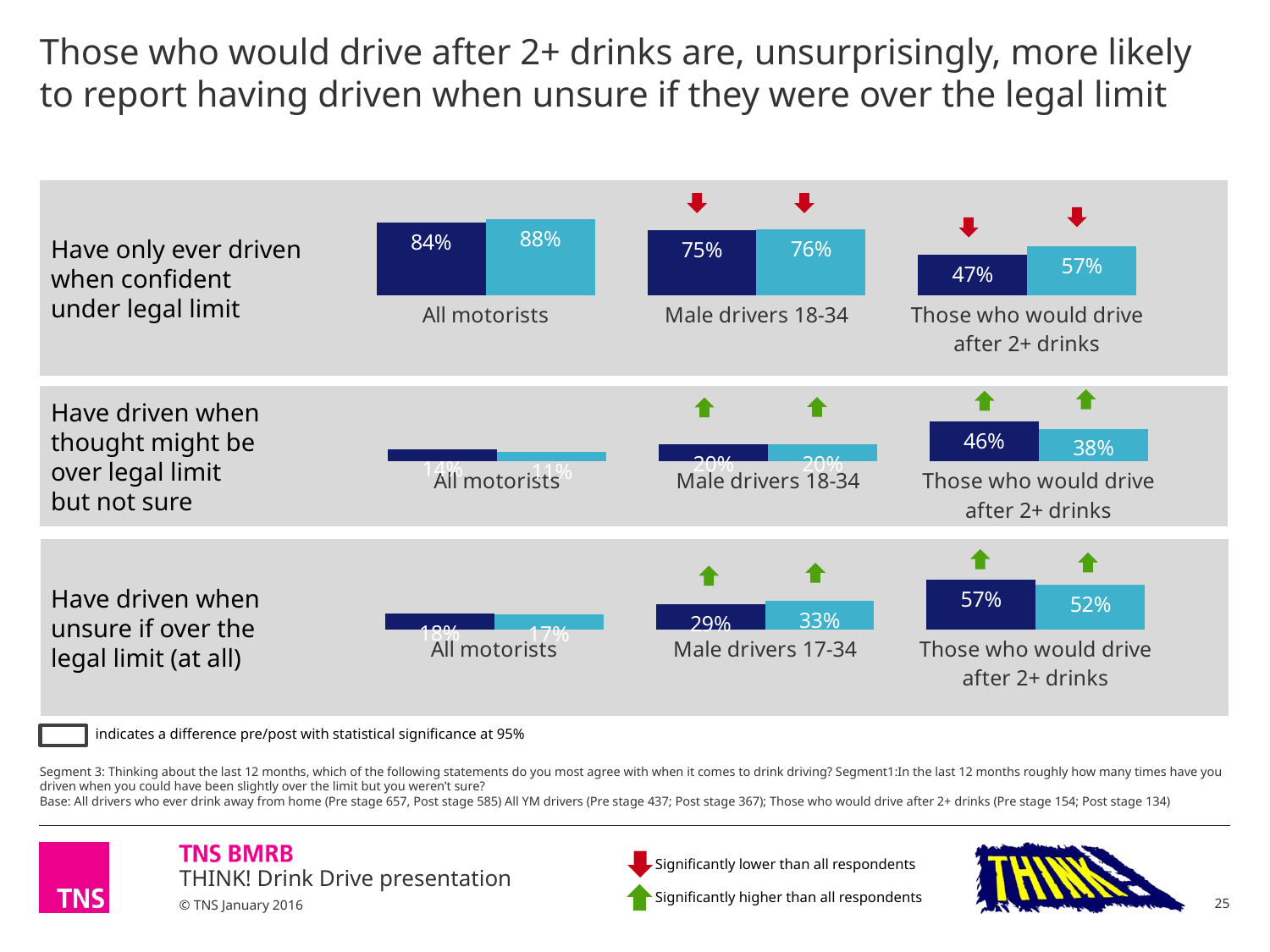
In the 'Have only ever driven when confident under legal limit' chart, what is the difference between the light blue and dark blue bars for Those who would drive after 2+ drinks? 10% In the 'Have only ever driven when confident under legal limit' chart, what is the value of the light blue bar for Those who would drive after 2+ drinks? 57% In the 'Have driven when thought might be over legal limit but not sure' chart, what is the value of the dark blue bar for Those who would drive after 2+ drinks? 46% In the 'Have driven when thought might be over legal limit but not sure' chart, what is the value of the light blue bar for Those who would drive after 2+ drinks? 38% In the 'Have driven when unsure if over the legal limit (at all)' chart, what is the value of the dark blue bar for Those who would drive after 2+ drinks? 57% In the 'Have driven when unsure if over the legal limit (at all)' chart, what is the difference between the dark blue bar for Those who would drive after 2+ drinks and the dark blue bar for Male drivers 17-34? 28% In the 'Have driven when unsure if over the legal limit (at all)' chart, which is larger for Those who would drive after 2+ drinks: the dark blue bar or the light blue bar? dark blue bar In the 'Have only ever driven when confident under legal limit' chart, what is the value of the dark blue bar for All motorists? 84% What type of chart is used on this slide? bar chart In the 'Have only ever driven when confident under legal limit' chart, which group has the lowest dark blue bar value? Those who would drive after 2+ drinks In the 'Have driven when unsure if over the legal limit (at all)' chart, what is the value of the light blue bar for Male drivers 17-34? 33% In the 'Have only ever driven when confident under legal limit' chart, what is the value of the light blue bar for All motorists? 88%